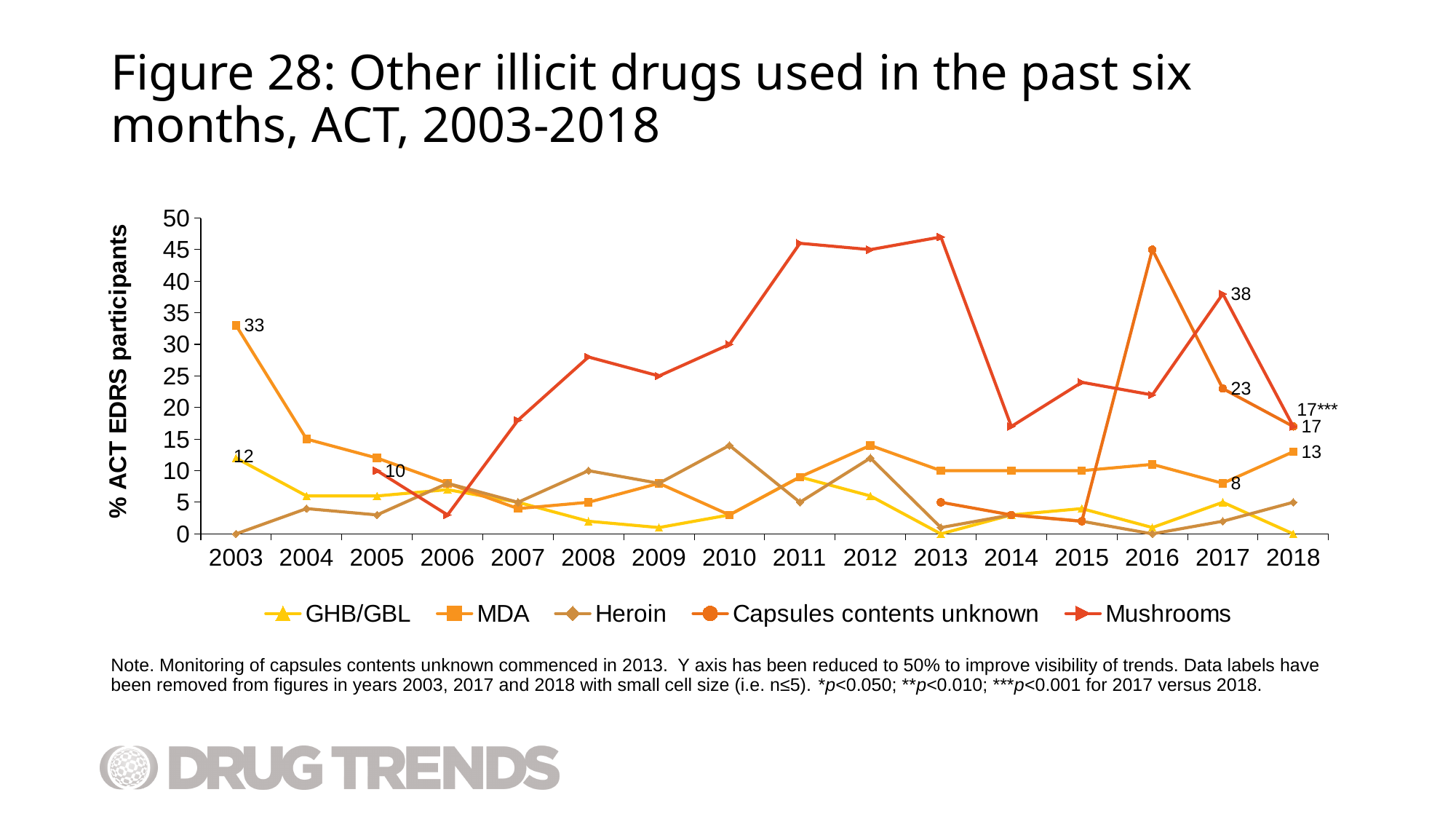
What is the difference between the MDA values in 2018 and 2017? 5 Which series has the higher value in 2017, Mushrooms or Capsules contents unknown? Mushrooms How many years are shown along the x axis? 16 What is the label on the y axis? % ACT EDRS participants What is the value for MDA in 2003? 33 What is the value for GHB/GBL in 2003? 12 What is the value for Capsules contents unknown in 2017? 23 Is the value for Mushrooms in 2011 greater or less than 40? greater What is the value for Mushrooms in 2017? 38 What is the value for MDA in 2018? 13 What kind of chart is shown on the slide? Line chart How many series does the legend list? 5